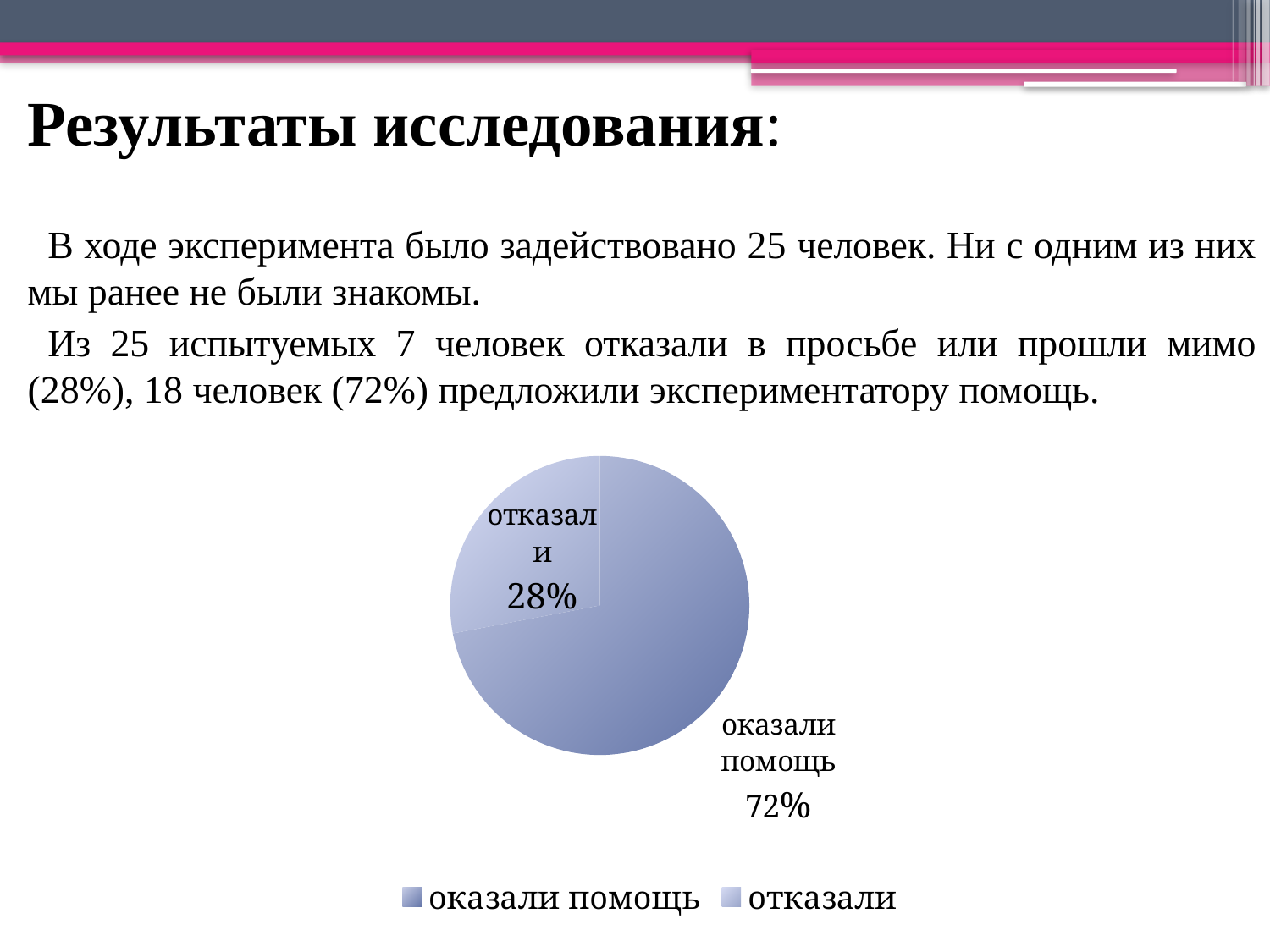
What share of the pie does the "оказали помощь" slice represent? 72% Which slice of the pie is the largest? оказали помощь Which is larger: the "оказали помощь" slice or the "отказали" slice? оказали помощь How many entries does the legend list? 2 How many slices does the pie chart have? 2 Is the value for "отказали" greater or less than 50%? less What kind of chart is shown on the slide? pie chart Which slice of the pie is the smallest? отказали Where is the legend positioned relative to the pie chart? below the chart What share of the pie does the "отказали" slice represent? 28% Which legend entry is listed first? оказали помощь What is the difference in percentage points between the "оказали помощь" and "отказали" slices? 44